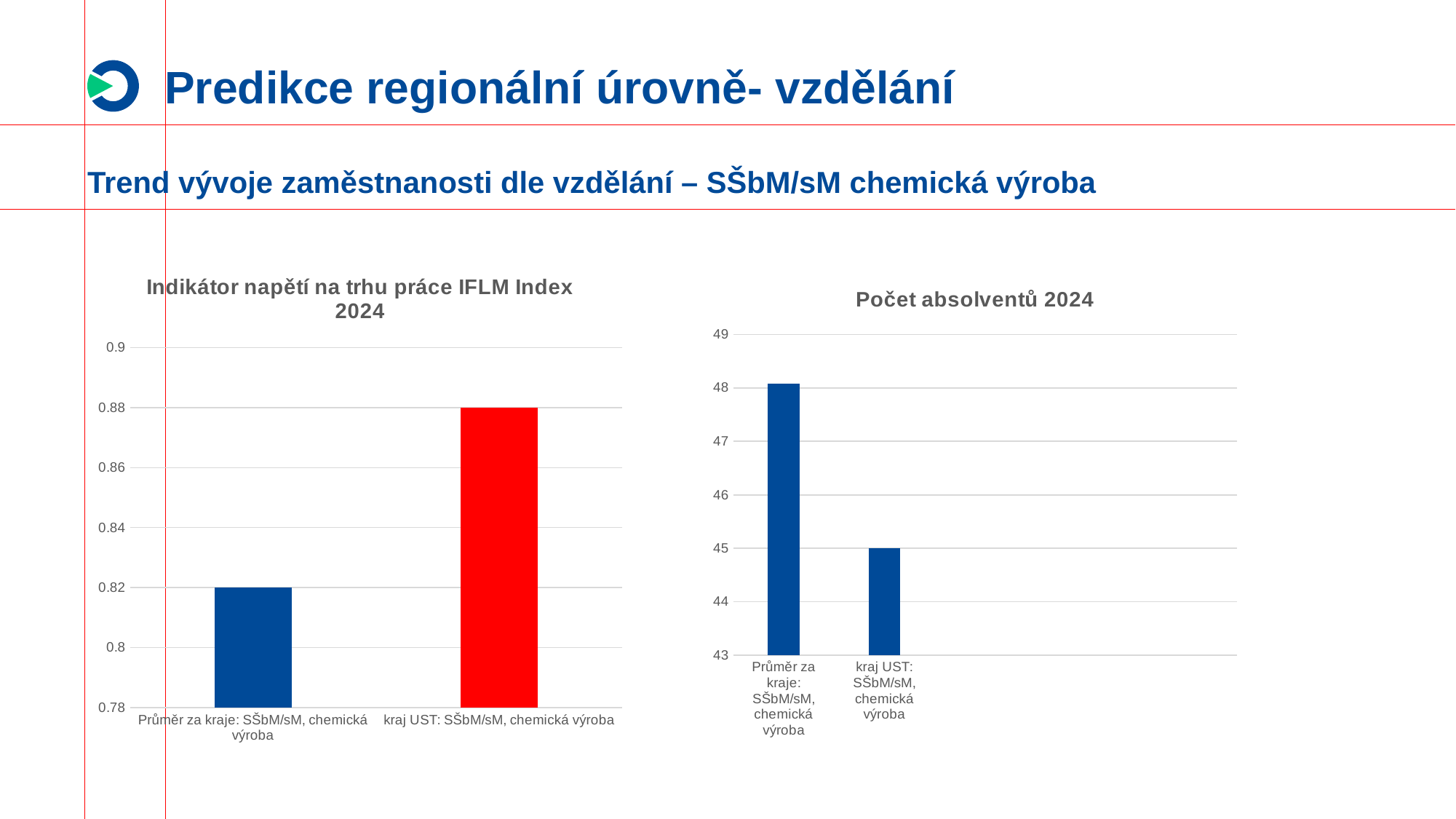
In the chart titled 'Indikátor napětí na trhu práce IFLM Index 2024', how many bars are plotted? 2 What kind of chart is the one titled 'Indikátor napětí na trhu práce IFLM Index 2024'? bar chart In the chart titled 'Počet absolventů 2024', which category has the lower value? kraj UST: SŠbM/sM, chemická výroba In the chart titled 'Indikátor napětí na trhu práce IFLM Index 2024', what is the value for 'kraj UST: SŠbM/sM, chemická výroba'? 0.88 In the chart titled 'Indikátor napětí na trhu práce IFLM Index 2024', what colour is the bar for 'kraj UST: SŠbM/sM, chemická výroba'? red In the chart titled 'Počet absolventů 2024', is the value for 'Průměr za kraje' larger or smaller than the value for 'kraj UST'? larger In the chart titled 'Indikátor napětí na trhu práce IFLM Index 2024', which category has the higher value? kraj UST: SŠbM/sM, chemická výroba In the chart titled 'Indikátor napětí na trhu práce IFLM Index 2024', what is the value for 'Průměr za kraje: SŠbM/sM, chemická výroba'? 0.82 In the chart titled 'Počet absolventů 2024', is the value for 'Průměr za kraje: SŠbM/sM, chemická výroba' greater or less than 47? greater In the chart titled 'Indikátor napětí na trhu práce IFLM Index 2024', what is the difference between the value for 'kraj UST' and the value for 'Průměr za kraje'? 0.06 In the chart titled 'Počet absolventů 2024', what is the value for 'kraj UST: SŠbM/sM, chemická výroba'? 45 How many charts are shown on the slide? 2